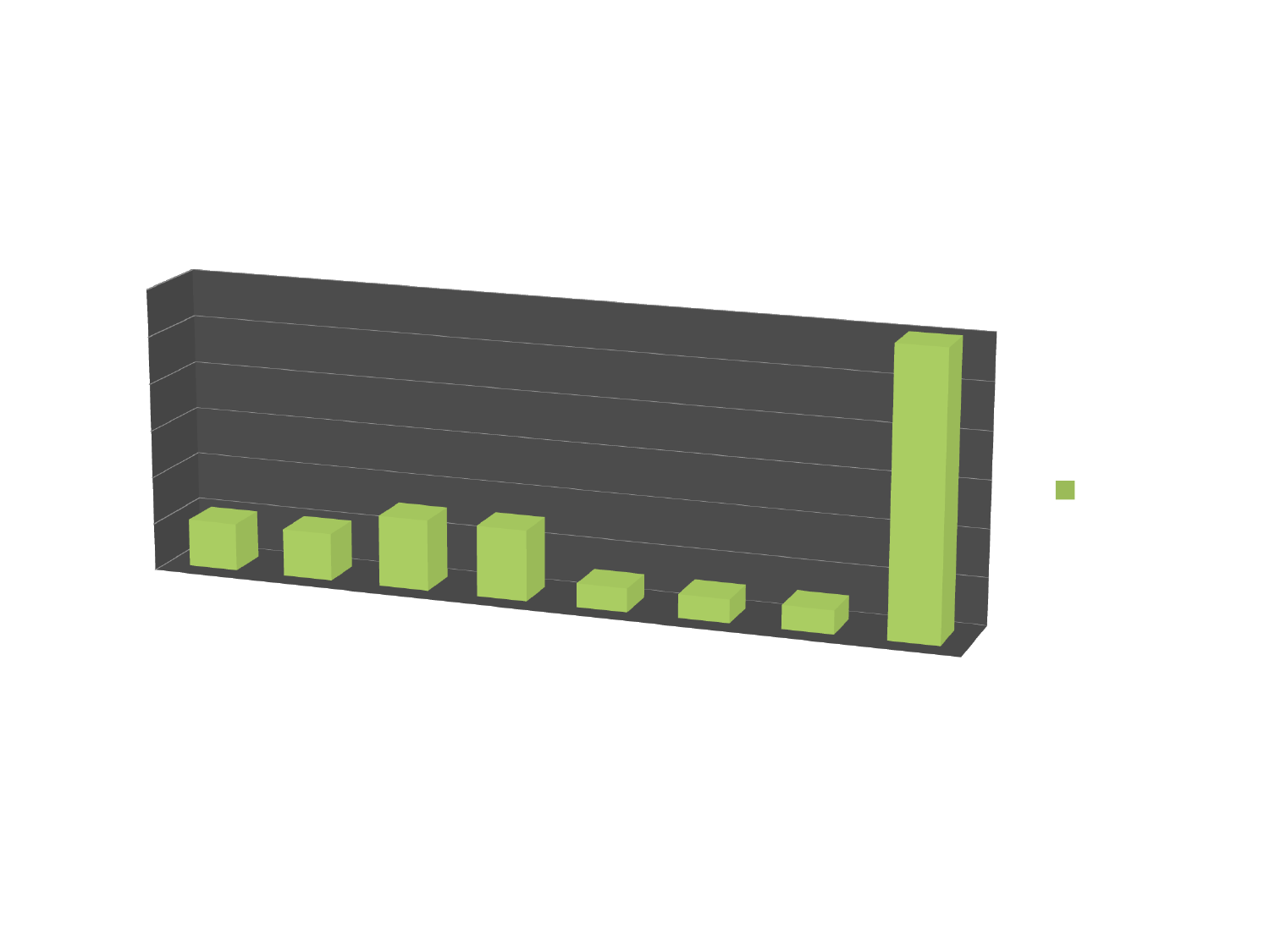
Is the chart drawn in 3D or flat 2D? 3D Which is larger, the first bar from the left or the rightmost bar? the rightmost bar What kind of chart is shown on the slide? bar chart Which is larger, the fourth bar from the left or the sixth bar from the left? the fourth bar How many series does the legend list? 1 What colour are the bars in the chart? green How many bars are plotted in the chart? 8 Which bar is the highest in the chart, counting from the left? the eighth (rightmost) bar Which is larger, the third bar from the left or the fifth bar from the left? the third bar